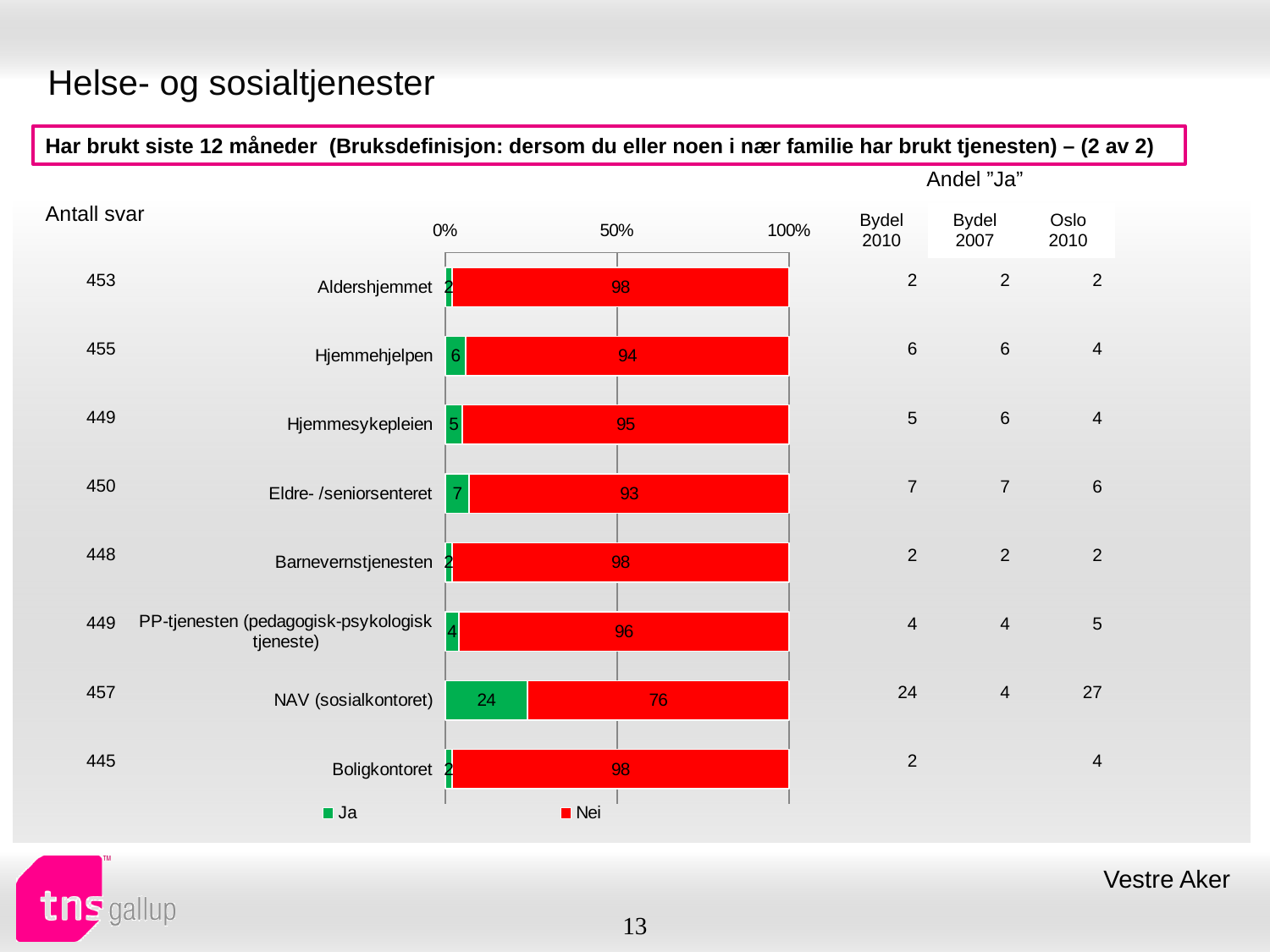
How many series does the legend list? 2 How many categories are shown in the chart? 8 What is the 'Ja' value for Hjemmehjelpen? 6 What is the 'Ja' value for Eldre- /seniorsenteret? 7 What kind of chart is shown on the slide? stacked bar chart Which is larger, the 'Ja' value for Hjemmesykepleien or for Eldre- /seniorsenteret? Eldre- /seniorsenteret Which category has the highest 'Ja' value? NAV (sosialkontoret) Which category has the lowest 'Nei' value? NAV (sosialkontoret) Is the 'Nei' value for NAV (sosialkontoret) greater or less than 50%? greater What is the difference between the 'Nei' values for Aldershjemmet and NAV (sosialkontoret)? 22 What is the 'Nei' value for NAV (sosialkontoret)? 76 What is the total of the stacked bar for PP-tjenesten (pedagogisk-psykologisk tjeneste)? 100